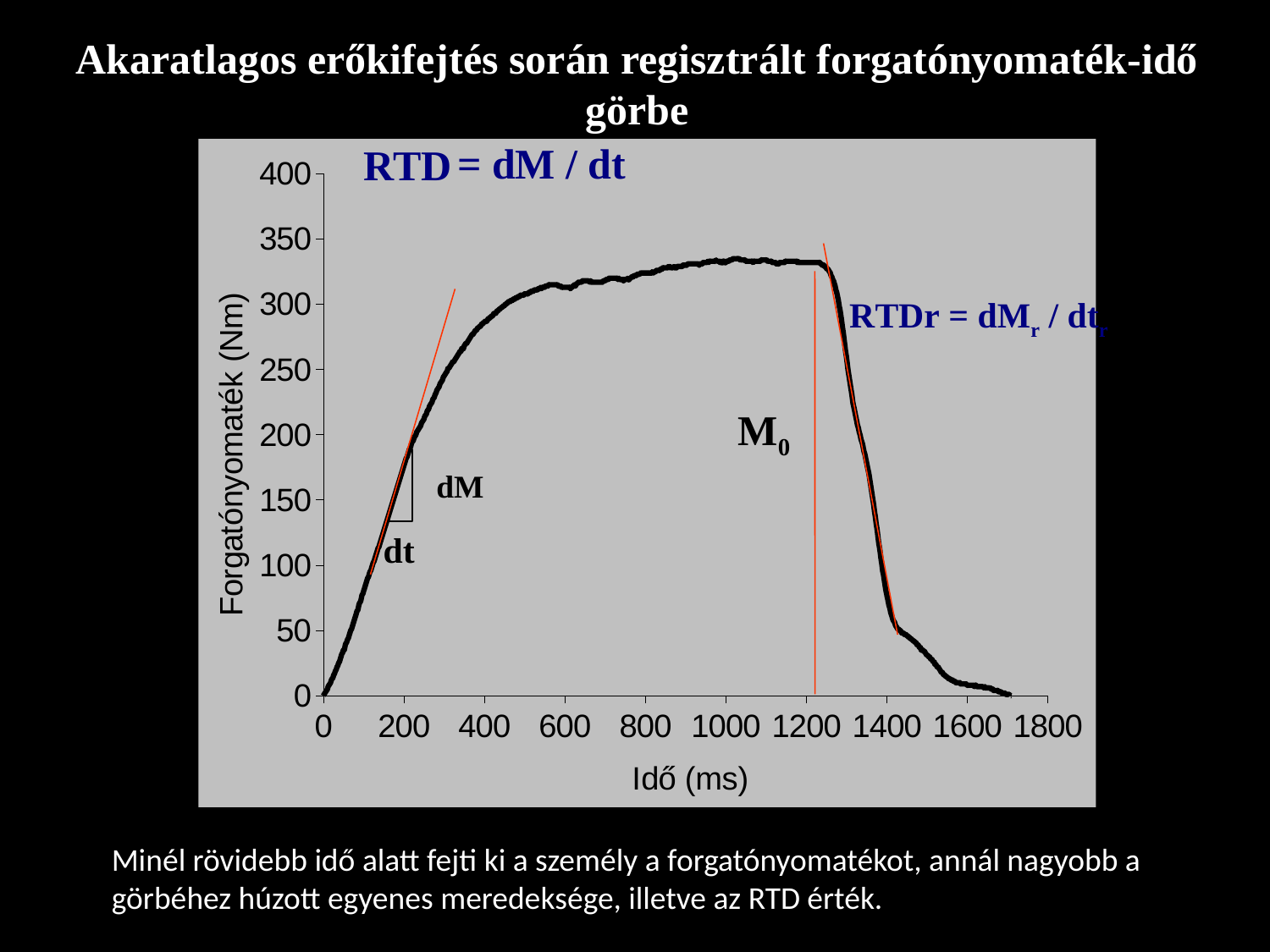
Is the torque value at 1600 ms greater or less than 50? less Is the torque value at 600 ms greater or less than 250? greater Which is larger, the torque value at 800 ms or at 200 ms? 800 ms Is the torque value at 200 ms greater or less than 250? less What formula is written in blue at the top of the chart area? RTD = dM / dt Does the curve rise or fall between 1200 ms and 1400 ms? fall Which is larger, the torque value at 1000 ms or at 1500 ms? 1000 ms What is the label of the vertical axis of the chart? Forgatónyomaték (Nm) Does the curve rise or fall between 0 ms and 400 ms? rise What kind of chart is shown on the slide? line chart